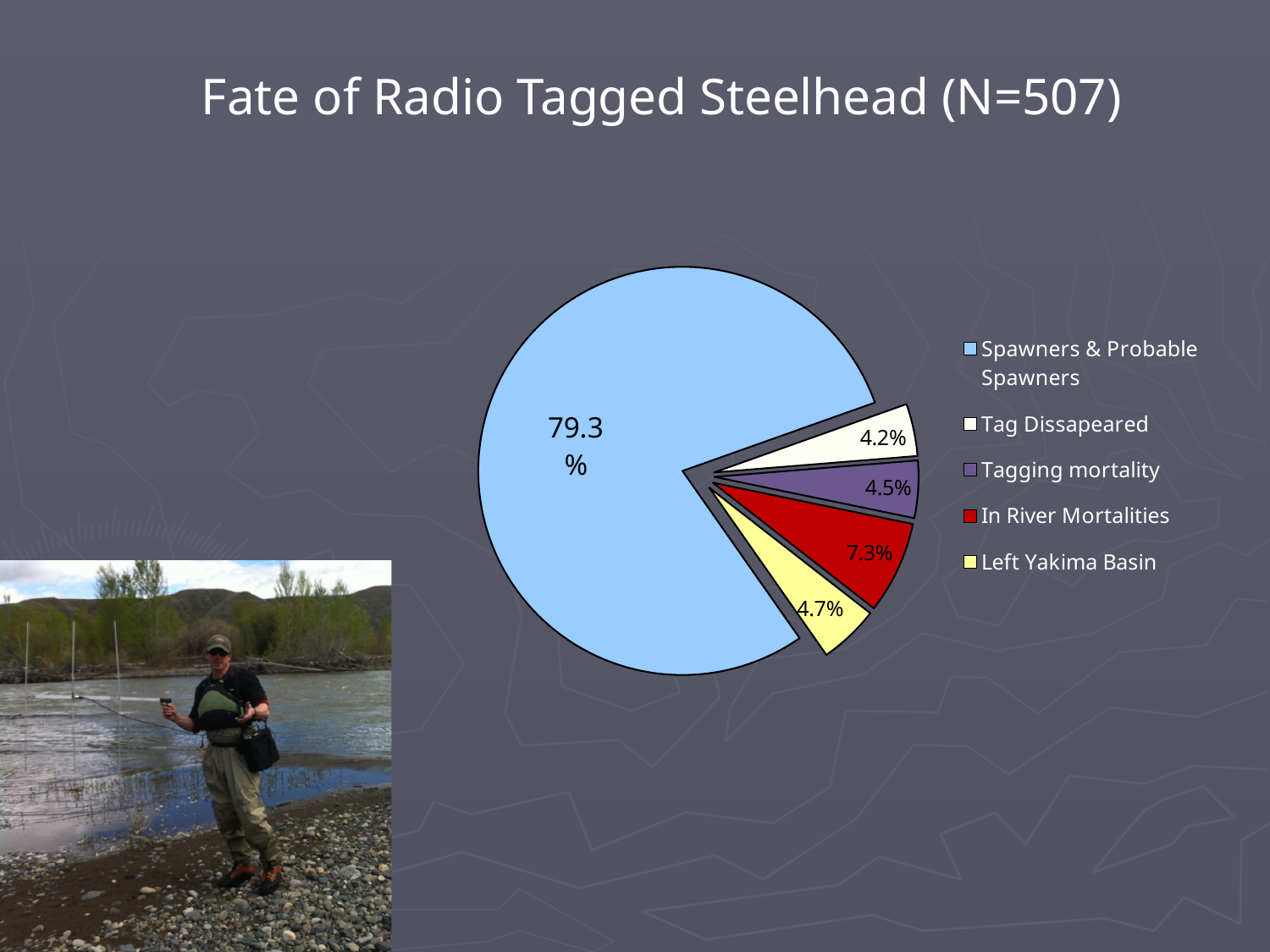
What share of the pie is Tag Dissapeared? 4.2% What kind of chart is shown on the slide? pie chart Which category has the largest slice of the pie? Spawners & Probable Spawners What is the difference between the In River Mortalities share and the Tagging mortality share? 2.8% How many categories does the legend list? 5 Which is larger, In River Mortalities or Left Yakima Basin? In River Mortalities What share of the pie is Left Yakima Basin? 4.7% What share of the pie is Tagging mortality? 4.5% Which category has the smallest slice of the pie? Tag Dissapeared What is the title of the chart? Fate of Radio Tagged Steelhead (N=507)